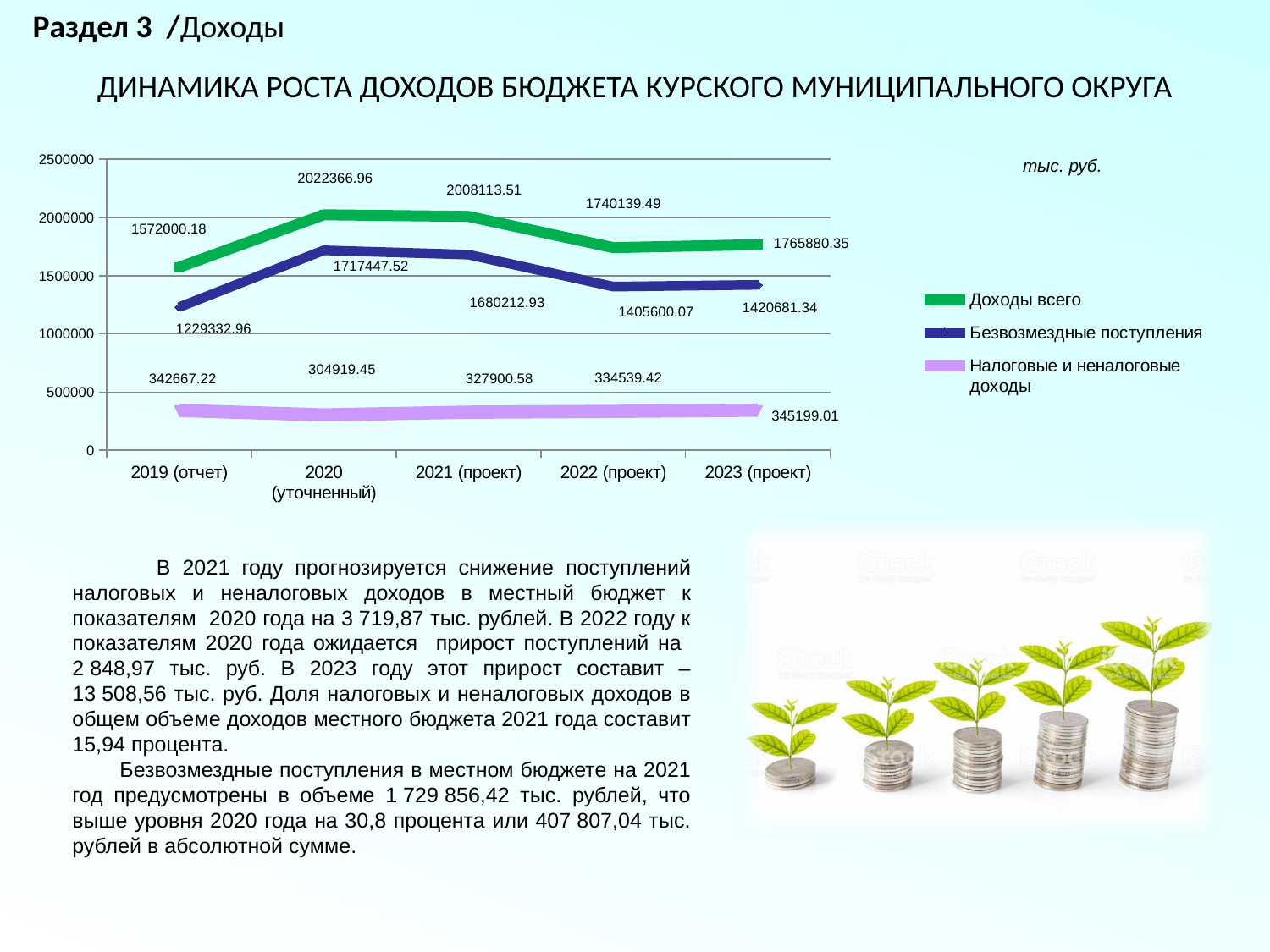
How many years are shown on the x axis? 5 What is the difference between Доходы всего in 2020 (уточненный) and 2019 (отчет)? 450366.78 Is the value of Безвозмездные поступления for 2019 (отчет) greater or less than 1500000? less What kind of chart is shown on the slide? line chart Which is larger: Доходы всего in 2021 (проект) or in 2022 (проект)? 2021 (проект) What is the value of Доходы всего for 2020 (уточненный)? 2022366.96 What is the value of Безвозмездные поступления for 2019 (отчет)? 1229332.96 How many series does the legend list? 3 In which year is Доходы всего highest? 2020 (уточненный) What is the difference between Безвозмездные поступления in 2023 (проект) and 2022 (проект)? 15081.27 In which year is Налоговые и неналоговые доходы lowest? 2020 (уточненный) What is the value of Налоговые и неналоговые доходы for 2023 (проект)? 345199.01